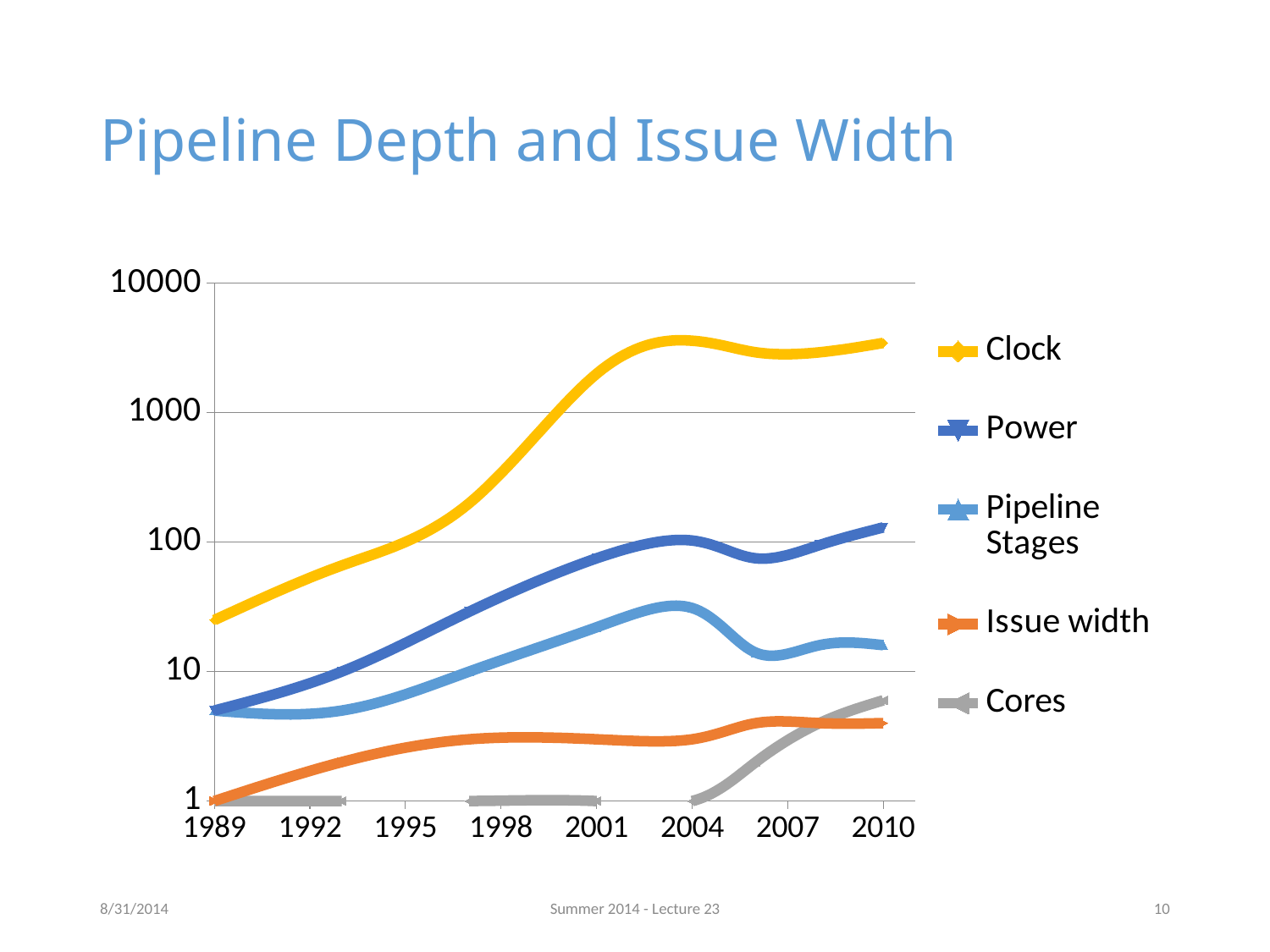
Is the value for Power in 1989 greater or less than 10? less Does the Clock series rise or fall from 1989 to 2004? rise What is the title of the slide? Pipeline Depth and Issue Width What kind of chart is shown on the slide? line chart Which series is plotted in yellow? Clock How many years are labelled on the x axis? 8 Is the value for Clock in 2010 greater or less than 1000? greater Is the value for Cores in 2010 greater or less than 10? less In 2004, which is larger: Power or Pipeline Stages? Power How many series does the legend list? 5 Which series has the highest value in 2010? Clock